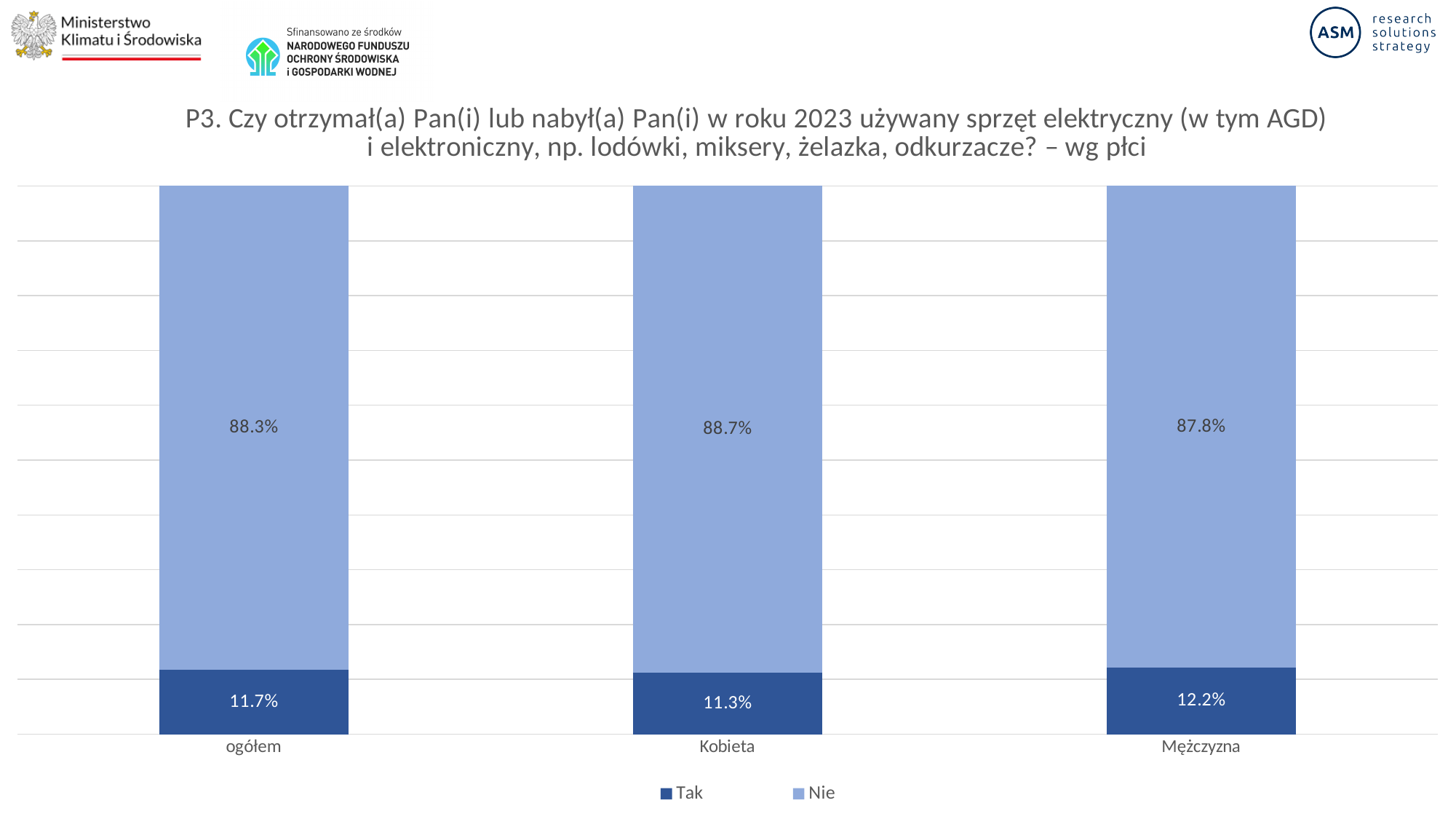
What is the value for "Tak" in the "Mężczyzna" category? 12.2% What is the value for "Nie" in the "Mężczyzna" category? 87.8% What is the total of the stacked bar for "ogółem"? 100% What is the difference between the "Tak" values for Mężczyzna and Kobieta? 0.9% What is the value for "Nie" in the "Kobieta" category? 88.7% How many categories are shown on the x axis? 3 What kind of chart is shown on the slide? Stacked bar chart How many series does the legend list? 2 Which category has the lowest value for "Tak"? Kobieta What is the value for "Tak" in the "ogółem" category? 11.7% Is the "Nie" value larger for Kobieta or for Mężczyzna? Kobieta Which category has the highest value for "Tak"? Mężczyzna